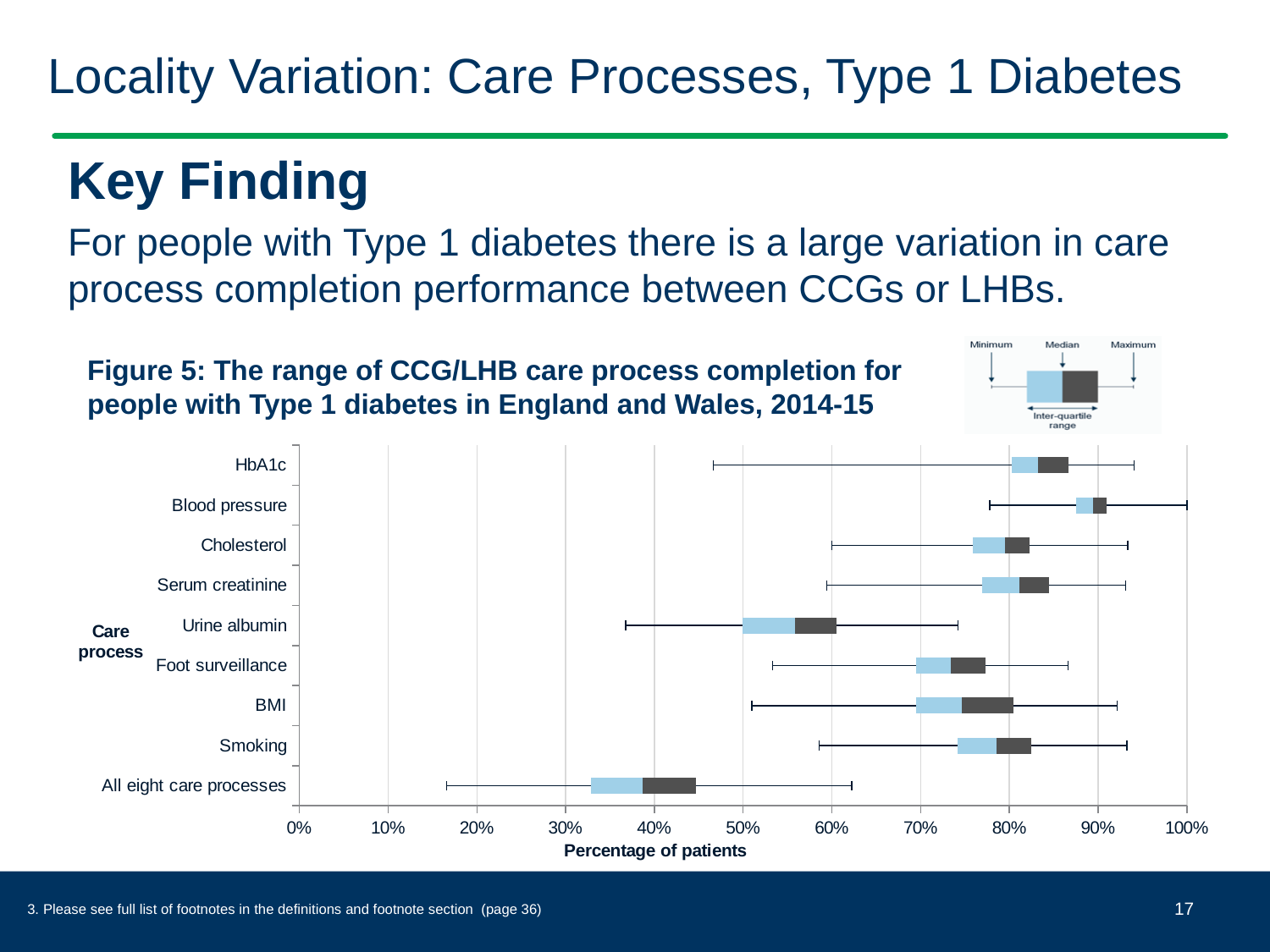
What does the light blue to dark grey box in the chart represent, according to the key? Inter-quartile range How many care processes are listed on the vertical axis of the chart? 9 Is the minimum value for All eight care processes greater or less than 20%? less Which care process has the highest median completion percentage? Blood pressure What is the title of the horizontal axis of the chart? Percentage of patients What kind of chart is shown in Figure 5? Box plot Is the median value for Urine albumin greater or less than 60%? less Is the median value for All eight care processes greater or less than 50%? less Which care process has the lowest median completion percentage? All eight care processes Which has the larger median completion percentage, Urine albumin or Foot surveillance? Foot surveillance